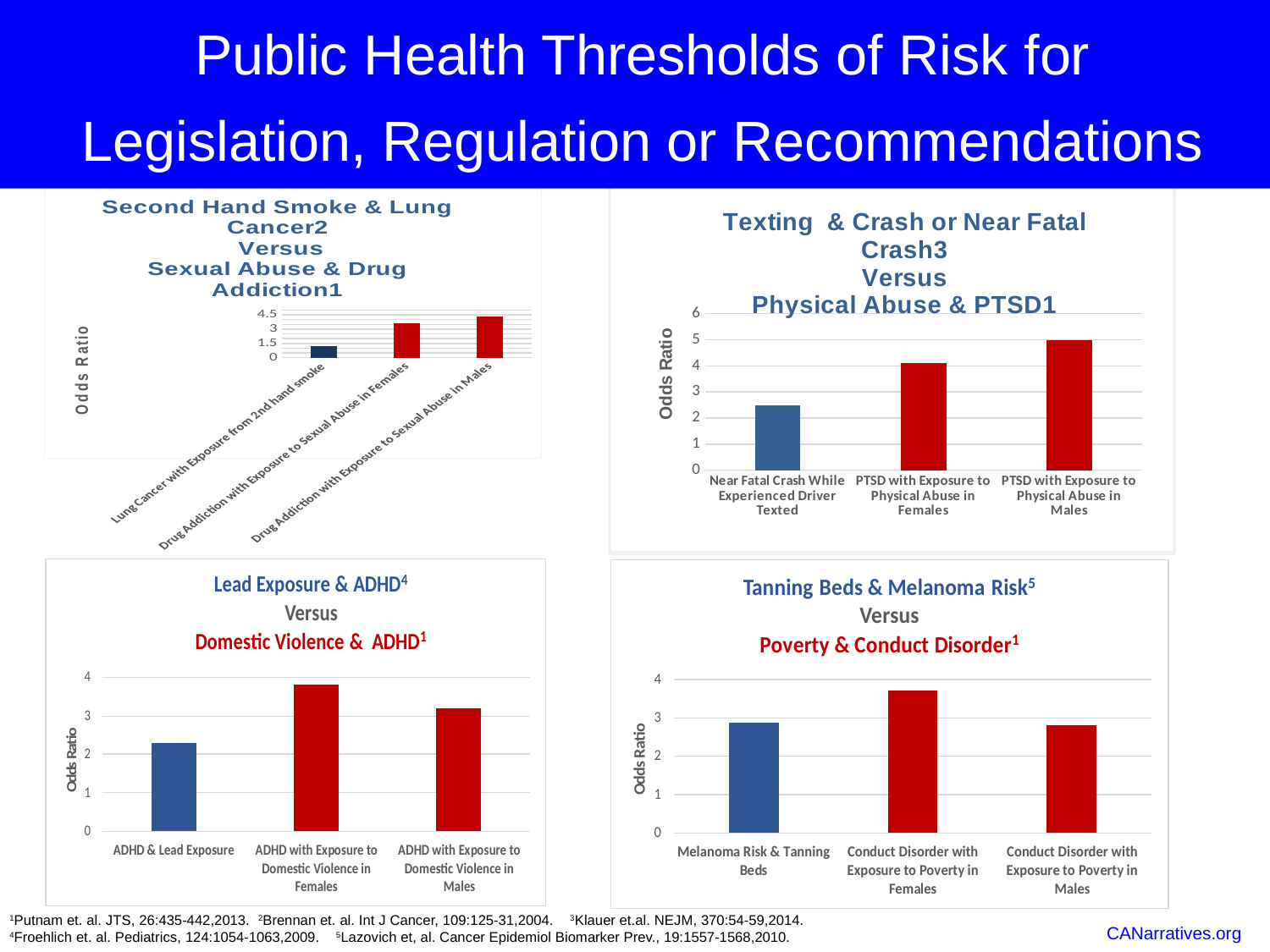
In the 'Lead Exposure & ADHD Versus Domestic Violence & ADHD' chart, which category has the lowest odds ratio? ADHD & Lead Exposure In the 'Second Hand Smoke & Lung Cancer Versus Sexual Abuse & Drug Addiction' chart, which category has the lowest odds ratio? Lung Cancer with Exposure from 2nd hand smoke In the 'Texting & Crash or Near Fatal Crash Versus Physical Abuse & PTSD' chart, which is larger: the odds ratio for PTSD with Exposure to Physical Abuse in Females or for Near Fatal Crash While Experienced Driver Texted? PTSD with Exposure to Physical Abuse in Females In the 'Lead Exposure & ADHD Versus Domestic Violence & ADHD' chart, which category has the highest odds ratio? ADHD with Exposure to Domestic Violence in Females In the 'Texting & Crash or Near Fatal Crash Versus Physical Abuse & PTSD' chart, is the odds ratio for Near Fatal Crash While Experienced Driver Texted greater or less than 3? less In the 'Tanning Beds & Melanoma Risk Versus Poverty & Conduct Disorder' chart, which category has the highest odds ratio? Conduct Disorder with Exposure to Poverty in Females In the 'Tanning Beds & Melanoma Risk Versus Poverty & Conduct Disorder' chart, what colour is the bar for Melanoma Risk & Tanning Beds? blue In the 'Lead Exposure & ADHD Versus Domestic Violence & ADHD' chart, what kind of chart is shown? bar chart In the 'Texting & Crash or Near Fatal Crash Versus Physical Abuse & PTSD' chart, which category has the highest odds ratio? PTSD with Exposure to Physical Abuse in Males In the 'Lead Exposure & ADHD Versus Domestic Violence & ADHD' chart, how many bars are plotted? 3 In the 'Tanning Beds & Melanoma Risk Versus Poverty & Conduct Disorder' chart, is the odds ratio for Melanoma Risk & Tanning Beds greater or less than 2? greater In the 'Lead Exposure & ADHD Versus Domestic Violence & ADHD' chart, is the odds ratio for ADHD with Exposure to Domestic Violence in Males greater or less than 3? greater